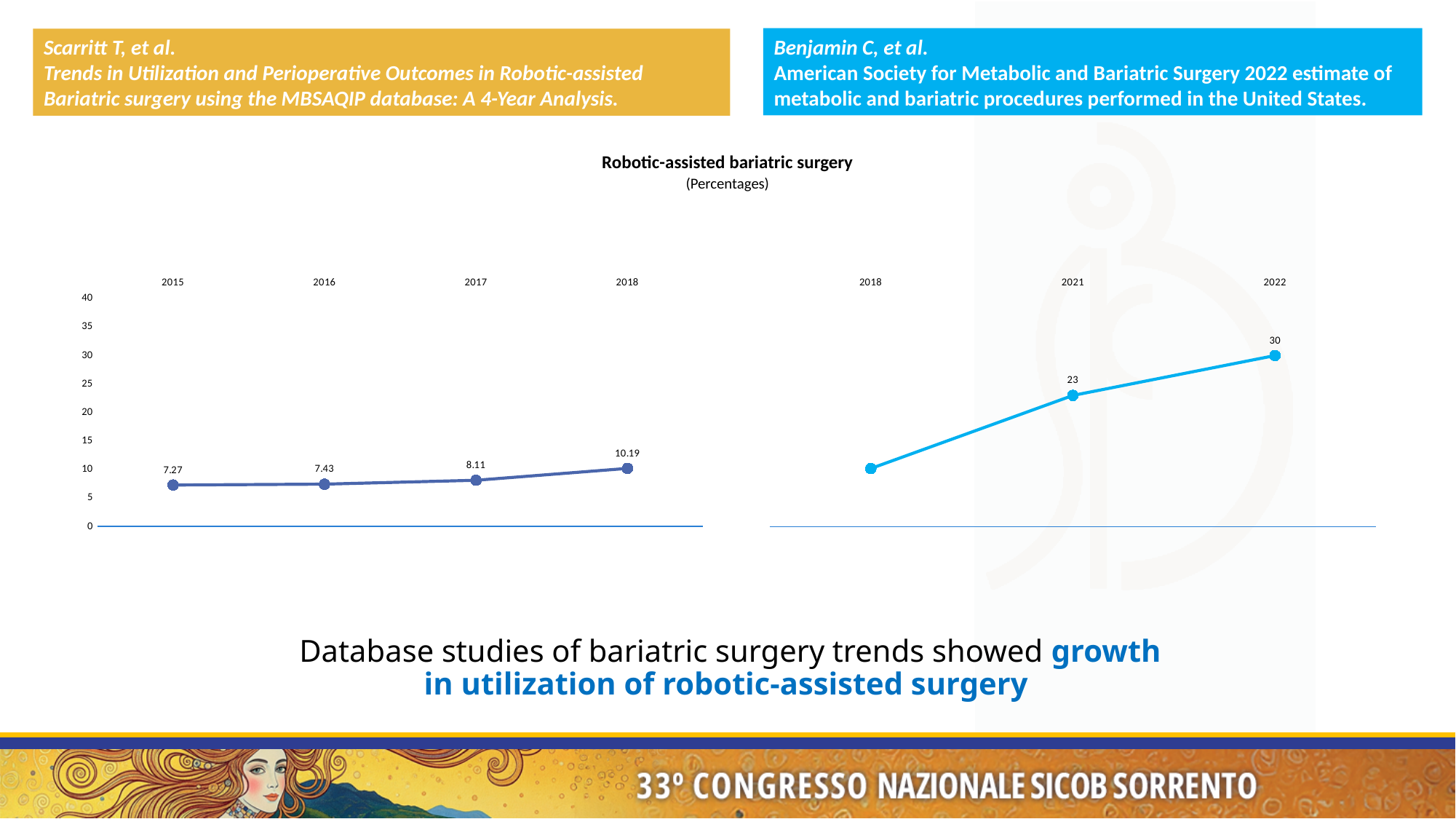
On the left chart (2015–2018), what is the difference between the 2018 and 2015 values? 2.92 On the right chart (2018–2022), what is the value for 2022? 30 What kind of chart is used on this slide? Line chart How many data points are plotted on the left chart (2015–2018)? 4 On the left chart (2015–2018), what is the value for 2017? 8.11 On the left chart (2015–2018), what is the value for 2018? 10.19 On the left chart (2015–2018), is the value for 2017 greater or less than 10? less On the left chart (2015–2018), which year has the highest value? 2018 On the right chart (2018–2022), what is the difference between the 2022 and 2021 values? 7 On the left chart (2015–2018), what is the value for 2015? 7.27 On the left chart (2015–2018), which year has the lowest value? 2015 On the right chart (2018–2022), what is the value for 2021? 23